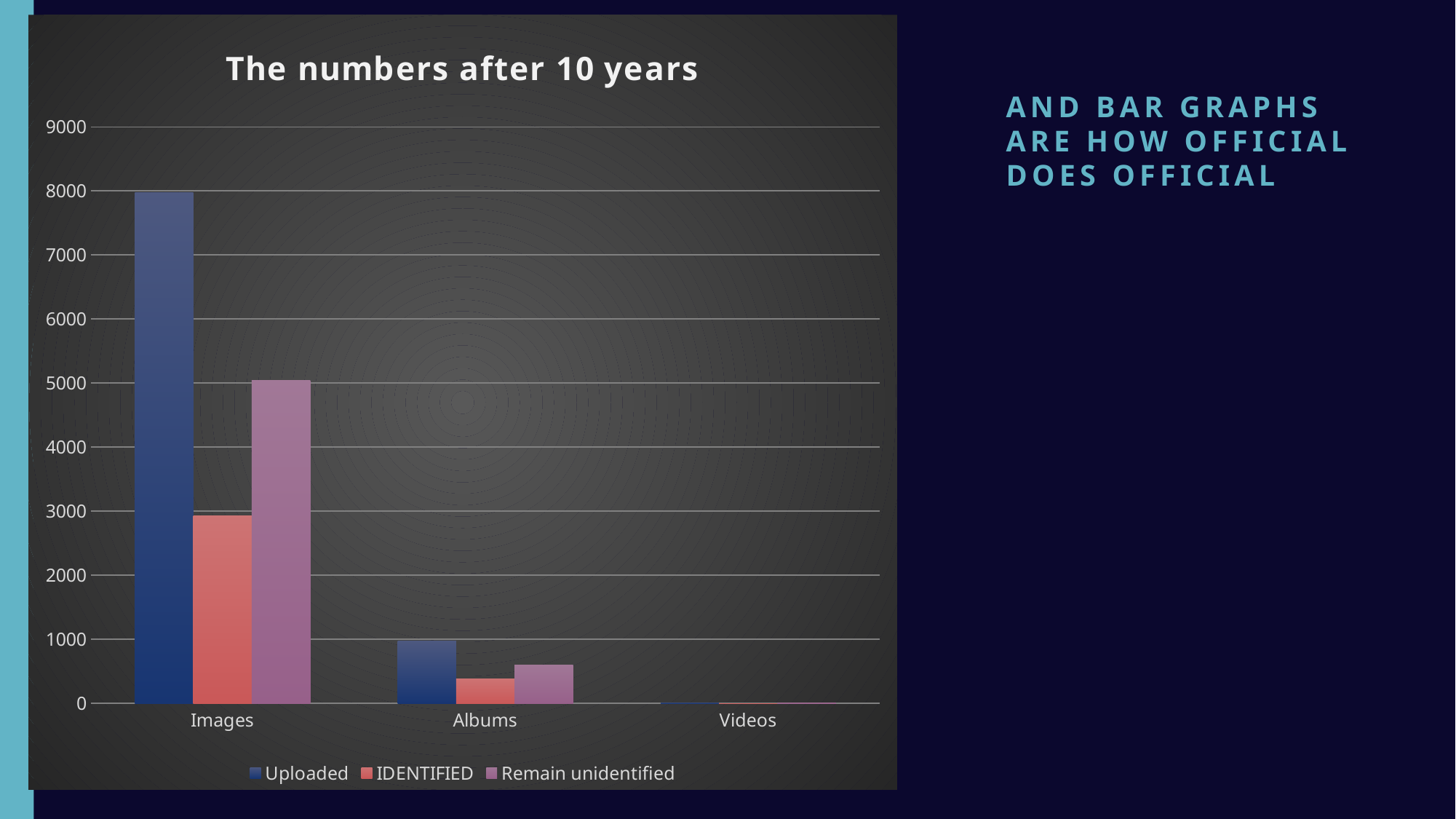
Which is larger: the Uploaded value for Albums or the Uploaded value for Videos? Albums What is the title of the chart? The numbers after 10 years How many series does the chart's legend list? 3 What are the three series listed in the chart's legend? Uploaded, IDENTIFIED, Remain unidentified How many categories are shown on the x axis of the chart? 3 Is the Uploaded value for Images greater or less than 7000? greater Which category has the highest Uploaded value? Images Is the IDENTIFIED value for Images greater or less than 4000? less Is the Remain unidentified value for Albums greater or less than 1000? less For Images, which is larger: IDENTIFIED or Remain unidentified? Remain unidentified What kind of chart is shown on the slide? bar chart Which category has the lowest Uploaded value? Videos